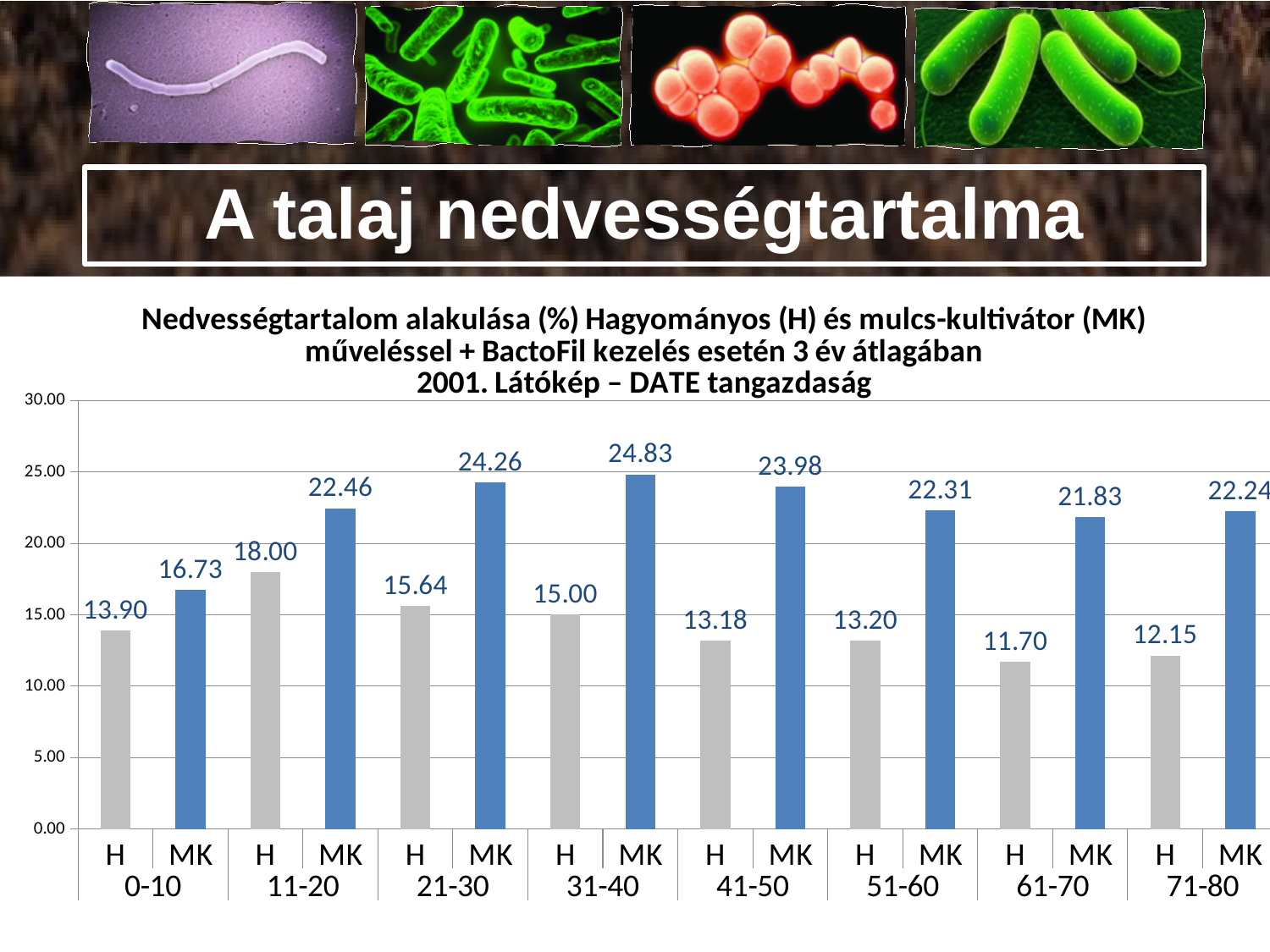
What is the moisture content value for H in the 0-10 depth group? 13.90 Which is larger, the H value for 11-20 or the H value for 21-30? H for 11-20 (18.00) How many depth groups are shown on the x axis? 8 Is the value for MK in the 41-50 depth group greater or less than 20.00? greater What is the difference between the MK and H values in the 21-30 depth group? 8.62 What kind of chart is shown on the slide? Bar chart What is the value for MK in the 71-80 depth group? 22.24 What is the value for H in the 61-70 depth group? 11.70 Which bar has the highest value on the chart? MK in 31-40 (24.83) What is the difference between the MK and H values in the 0-10 depth group? 2.83 What is the value for MK in the 31-40 depth group? 24.83 Which bar has the lowest value on the chart? H in 61-70 (11.70)